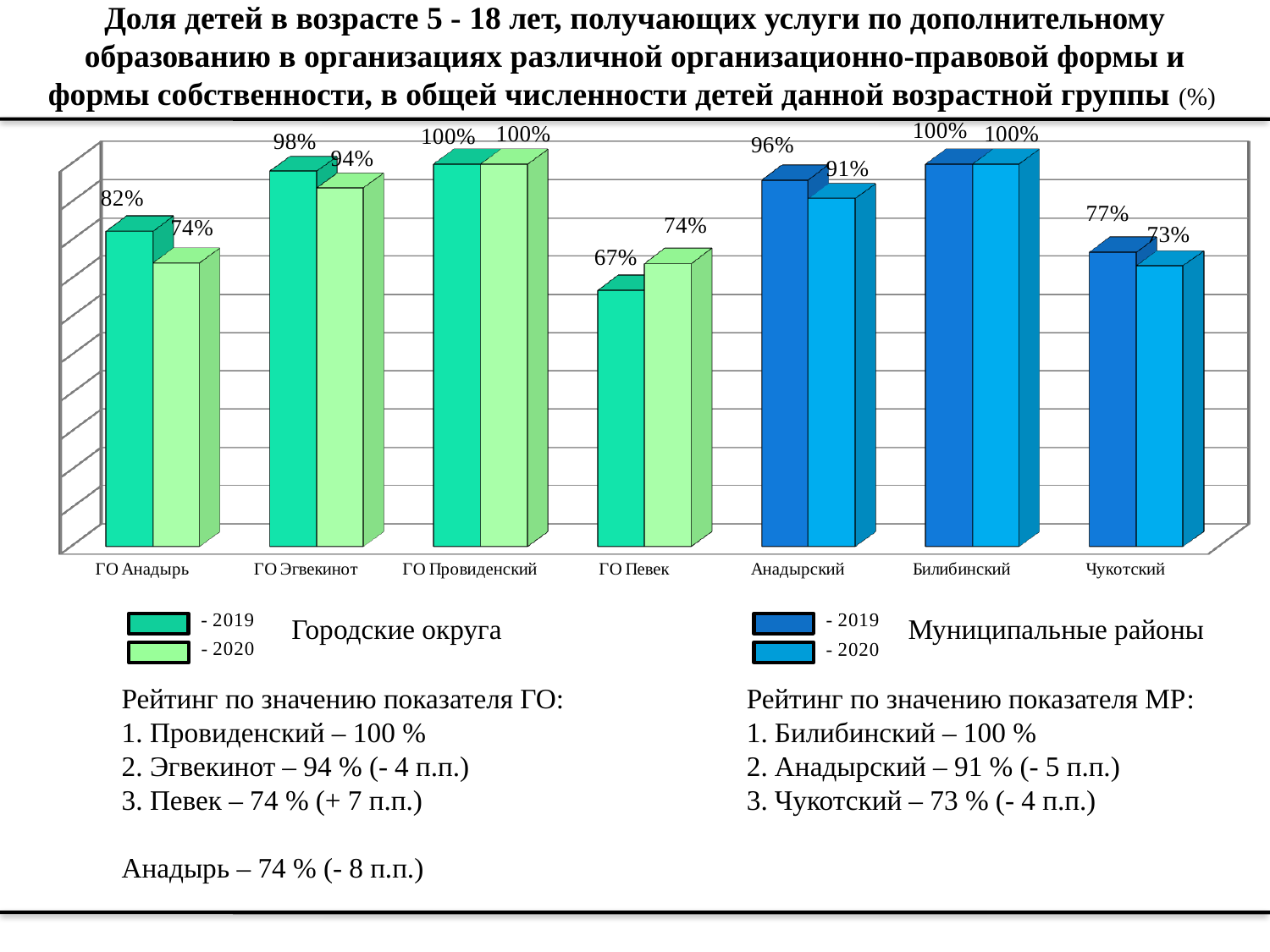
What is the difference between the 2020 values for ГО Эгвекинот and Анадырский? 3 percentage points Which two years does the legend list? 2019 and 2020 What is the 2020 value for ГО Анадырь? 74% Which category has the lowest 2020 value? Чукотский What is the 2020 value for Анадырский? 91% Which category has the lowest 2019 value? ГО Певек What kind of chart is shown on the slide? Bar chart What is the difference between the 2019 and 2020 values for ГО Анадырь? 8 percentage points Which is larger: the 2020 value for ГО Певек or the 2020 value for Чукотский? ГО Певек How many categories are shown on the x axis? 7 What is the 2019 value for Чукотский? 77% What is the 2019 value for ГО Певек? 67%